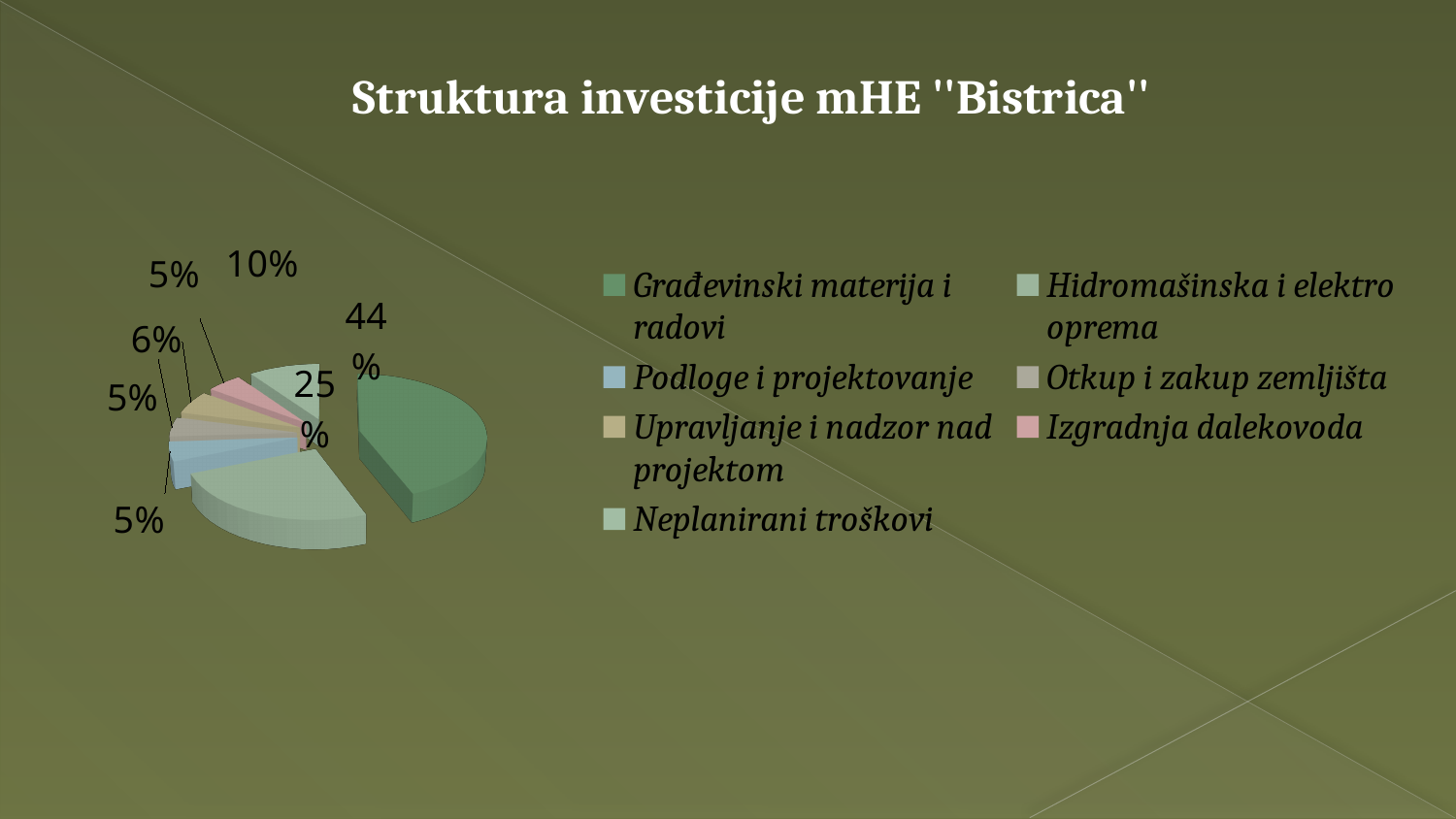
What kind of chart is shown on the slide? pie chart Which is larger: the share for Hidromašinska i elektro oprema or the share for Neplanirani troškovi? Hidromašinska i elektro oprema By how many percentage points does Građevinski materija i radovi exceed Hidromašinska i elektro oprema? 19 Which is larger: the share for Neplanirani troškovi or the share for Upravljanje i nadzor nad projektom? Neplanirani troškovi How many categories does the legend of the pie chart list? 7 What share of the investment is Upravljanje i nadzor nad projektom? 6% Which legend entry is shown in pink? Izgradnja dalekovoda What share of the investment is Hidromašinska i elektro oprema? 25% What is the title of the chart? Struktura investicije mHE ''Bistrica'' What share of the investment is Građevinski materija i radovi? 44% Which category has the largest share of the investment? Građevinski materija i radovi